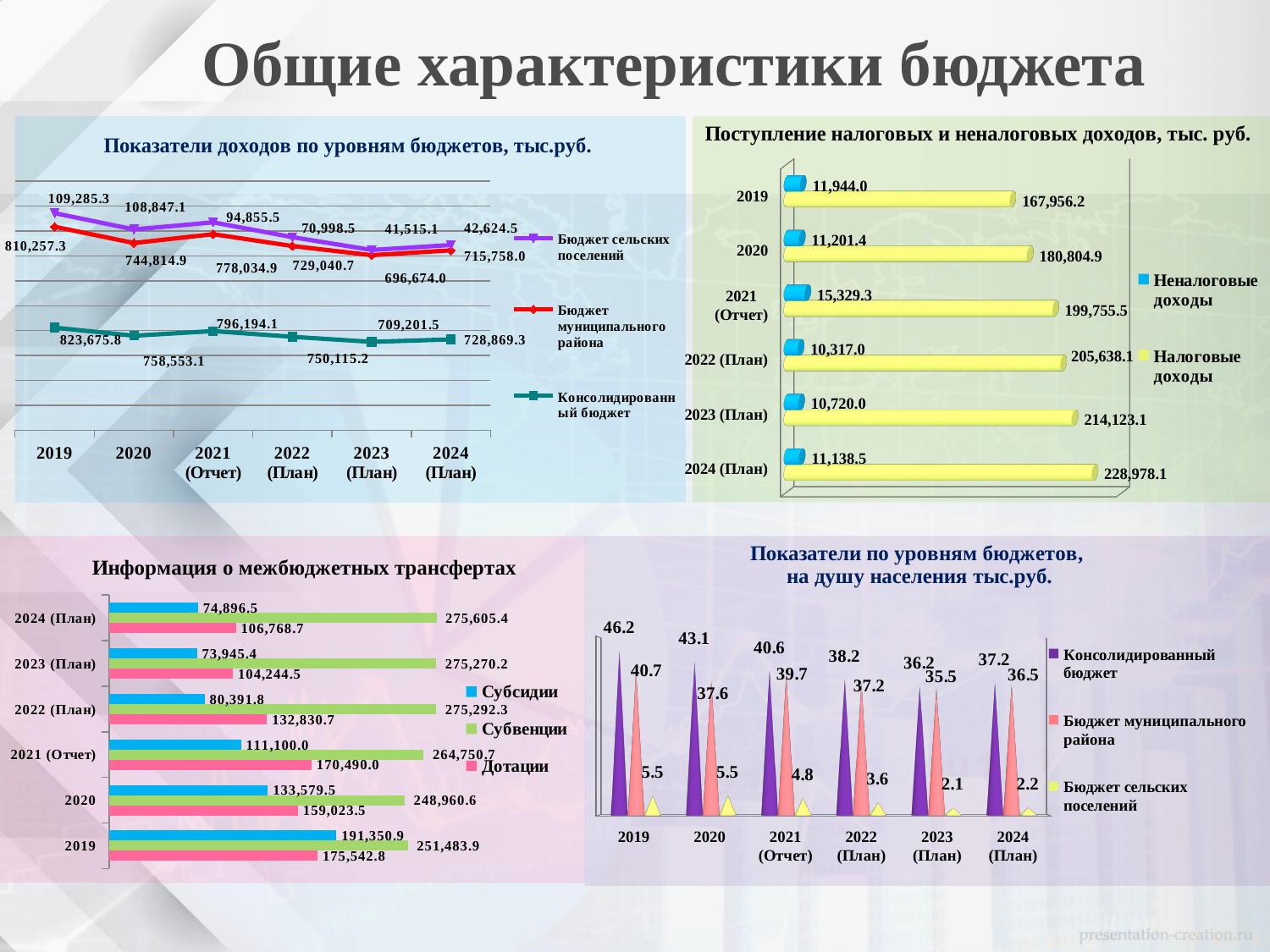
In the chart 'Поступление налоговых и неналоговых доходов, тыс. руб.', which year has the highest value of Неналоговые доходы? 2021 (Отчет) In the chart 'Информация о межбюджетных трансфертах', what is the value of Дотации for 2021 (Отчет)? 170,490.0 In the chart 'Информация о межбюджетных трансфертах', which is larger for 2019: Субсидии or Дотации? Субсидии In the chart 'Информация о межбюджетных трансфертах', what is the difference between Субвенции and Субсидии for 2024 (План)? 200,708.9 In the chart 'Показатели доходов по уровням бюджетов, тыс.руб.', what is the value for Бюджет сельских поселений in 2023 (План)? 41,515.1 In the chart 'Поступление налоговых и неналоговых доходов, тыс. руб.', do the Налоговые доходы values rise or fall from 2019 to 2024 (План)? rise In the chart 'Показатели по уровням бюджетов, на душу населения тыс.руб.', what is the value for Консолидированный бюджет in 2019? 46.2 In the chart 'Показатели доходов по уровням бюджетов, тыс.руб.', in which year is the Консолидированный бюджет value lowest? 2023 (План) In the chart 'Показатели по уровням бюджетов, на душу населения тыс.руб.', how many years are shown on the x axis? 6 In the chart 'Показатели доходов по уровням бюджетов, тыс.руб.', how many series does the legend list? 3 What kind of chart is 'Информация о межбюджетных трансфертах'? bar chart In the chart 'Поступление налоговых и неналоговых доходов, тыс. руб.', what is the value of Налоговые доходы for 2024 (План)? 228,978.1